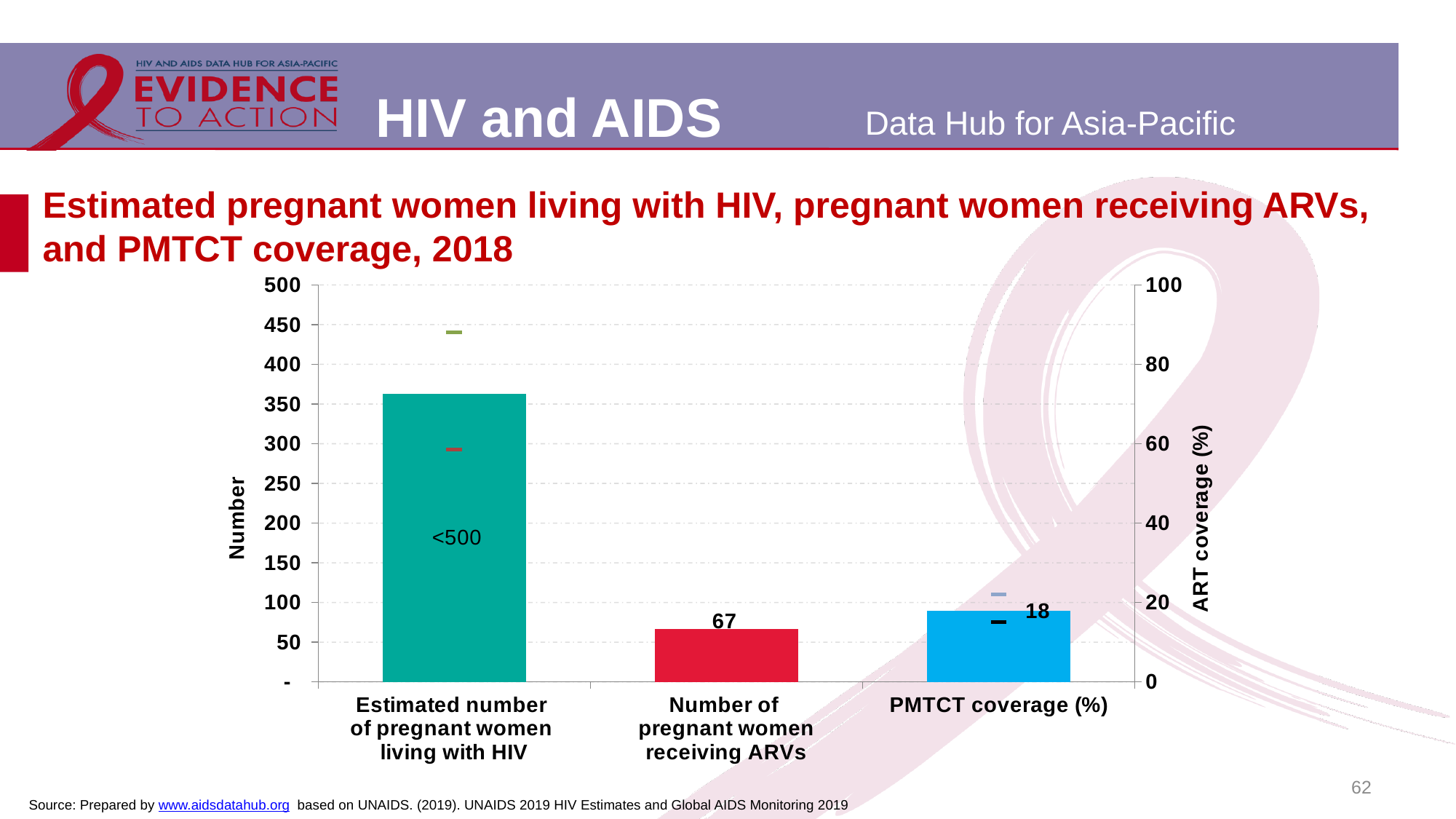
Which category has the tallest bar? Estimated number of pregnant women living with HIV What is the label of the left vertical axis? Number What is the value shown for PMTCT coverage (%)? 18 What year does the chart title say the data is for? 2018 What data label is printed on the bar for Estimated number of pregnant women living with HIV? <500 Is the bar for Estimated number of pregnant women living with HIV greater or less than 400 on the left axis? less What kind of chart is shown on the slide? Bar chart Which category has the shortest bar? Number of pregnant women receiving ARVs How many categories are shown on the x axis? 3 Is the bar for Estimated number of pregnant women living with HIV greater or less than 300 on the left axis? greater What is the value shown for Number of pregnant women receiving ARVs? 67 What is the label of the right vertical axis? ART coverage (%)